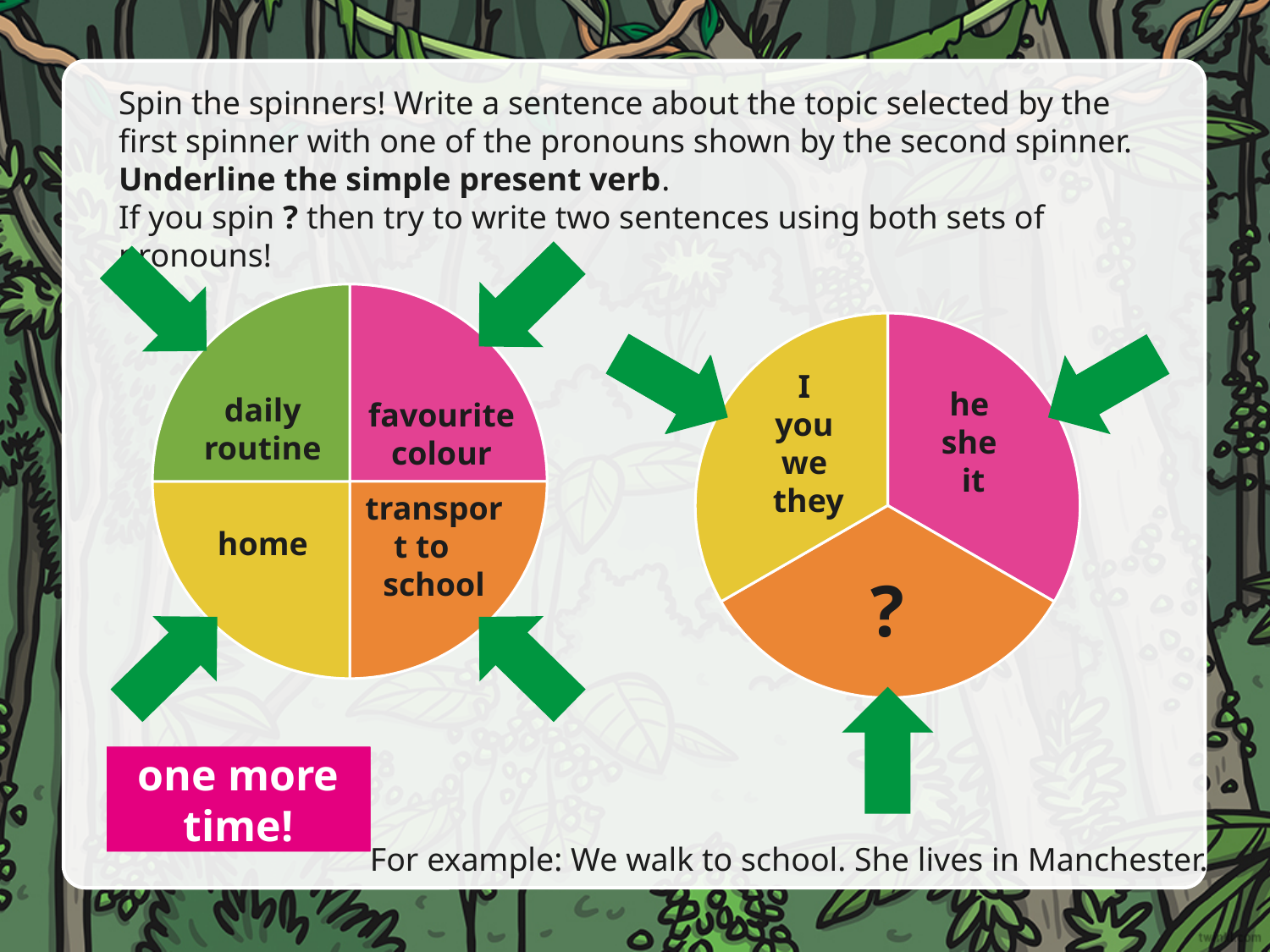
What kind of chart is the right spinner drawn as? pie chart On the left spinner, what label is in the pink segment? favourite colour What kind of chart is the left spinner drawn as? pie chart On the left spinner, what label is in the yellow segment? home On the right spinner, which pronouns are listed in the yellow segment? I, you, we, they How many segments does the left spinner have? 4 On the right spinner, what symbol is shown in the orange segment? ? On the right spinner, which pronouns are listed in the pink segment? he, she, it How many segments does the right spinner have? 3 On the left spinner, what label is in the orange segment? transport to school On the left spinner, what label is in the green segment? daily routine